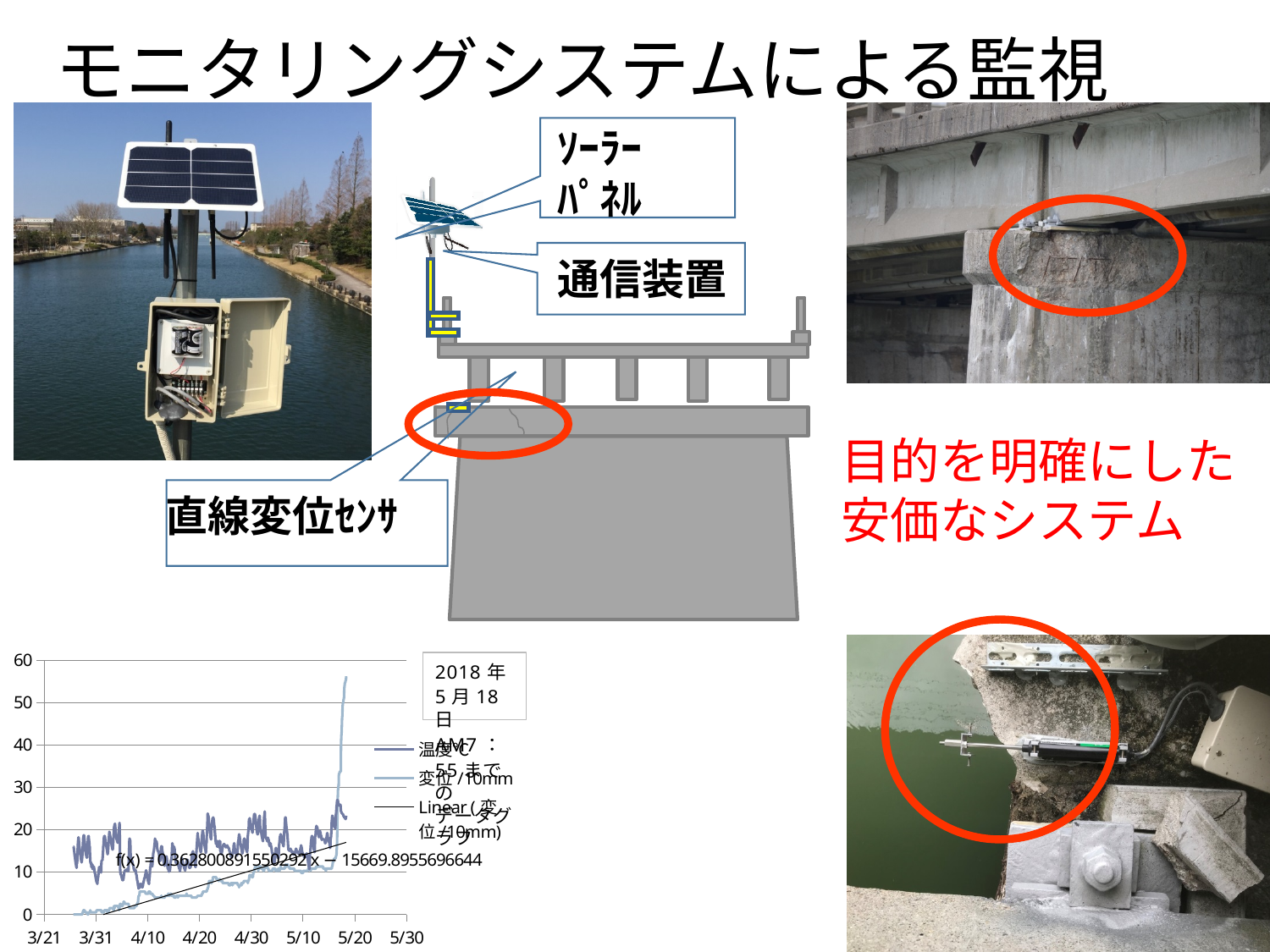
What is the first date label on the horizontal axis of the bottom-left chart? 3/21 What trendline equation is printed on the bottom-left chart? f(x) = 0.362800891550292 x − 15669.8955696644 In the bottom-left chart, is the peak value of the 変位/10mm series greater or less than 50? greater In the bottom-left chart, which series is drawn with the darker blue line? 温度℃ How many entries does the legend of the bottom-left chart list? 3 What kind of chart is shown at the bottom left of the slide? line chart In the bottom-left chart, near 5/20 which series has the larger value, 温度℃ or 変位/10mm? 変位/10mm In the bottom-left chart, does the 変位/10mm series rise or fall overall from 3/31 to 5/20? rise In the bottom-left chart, is the highest value of the 温度℃ series greater or less than 30? less What is the highest value shown on the vertical axis of the bottom-left chart? 60 How many date tick labels are shown on the horizontal axis of the bottom-left chart? 8 What is the last date label on the horizontal axis of the bottom-left chart? 5/30